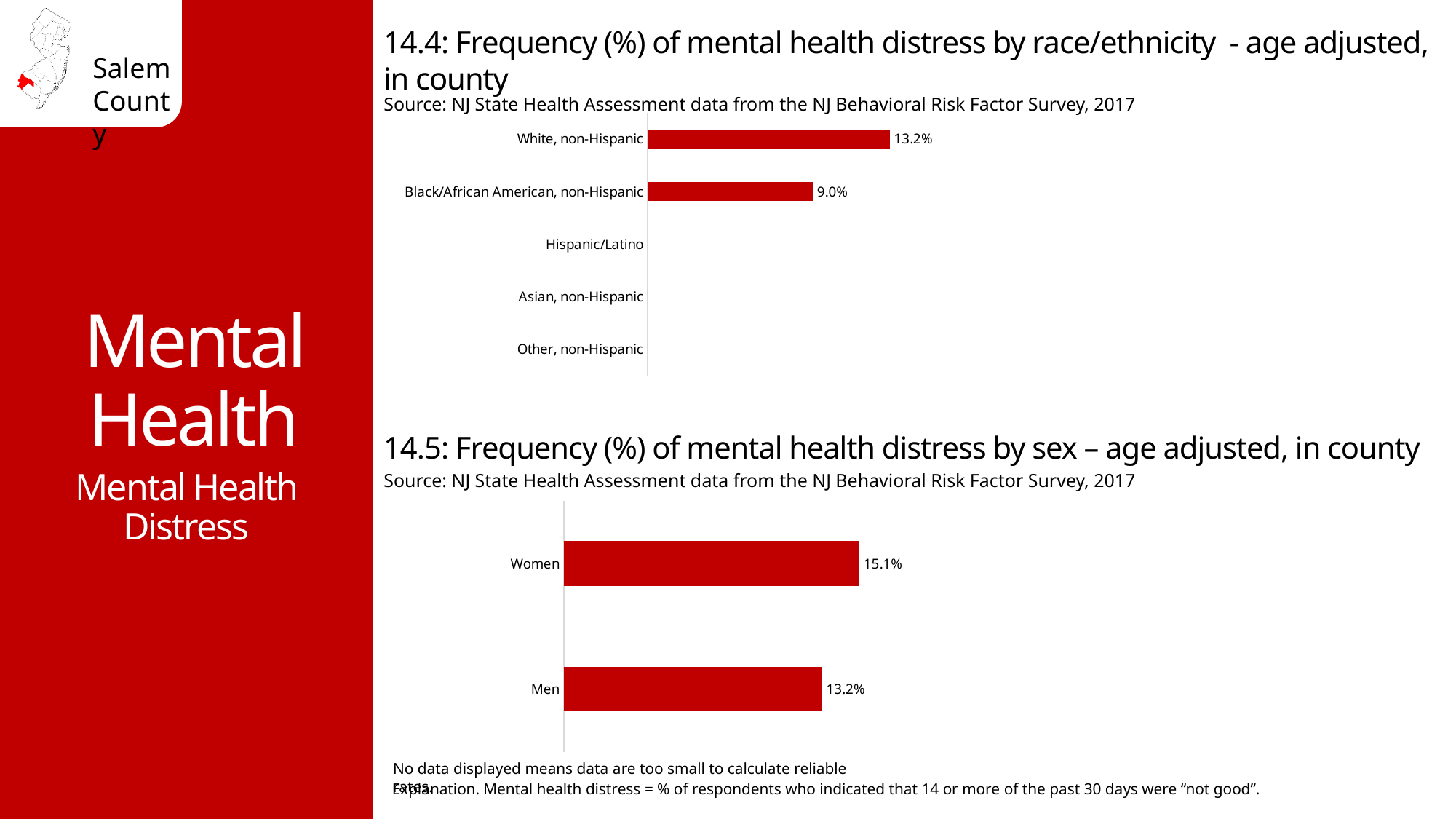
What is the source cited for chart 14.5 (mental health distress by sex)? NJ State Health Assessment data from the NJ Behavioral Risk Factor Survey, 2017 In the chart 14.4 (mental health distress by race/ethnicity), how many categories are listed on the axis? 5 In the chart 14.5 (mental health distress by sex), what is the value for Men? 13.2% In the chart 14.4 (mental health distress by race/ethnicity), which category has the highest value? White, non-Hispanic In the chart 14.5 (mental health distress by sex), what is the value for Women? 15.1% In the chart 14.4 (mental health distress by race/ethnicity), what is the value for Black/African American, non-Hispanic? 9.0% In the chart 14.5 (mental health distress by sex), which category has the higher value, Women or Men? Women What kind of chart is chart 14.4 (mental health distress by race/ethnicity)? Bar chart In the chart 14.4 (mental health distress by race/ethnicity), what is the difference between the White, non-Hispanic and Black/African American, non-Hispanic values? 4.2% In the chart 14.4 (mental health distress by race/ethnicity), what is the value for White, non-Hispanic? 13.2% In the chart 14.5 (mental health distress by sex), what is the difference between the Women and Men values? 1.9% In the chart 14.4 (mental health distress by race/ethnicity), how many categories have a bar displayed? 2